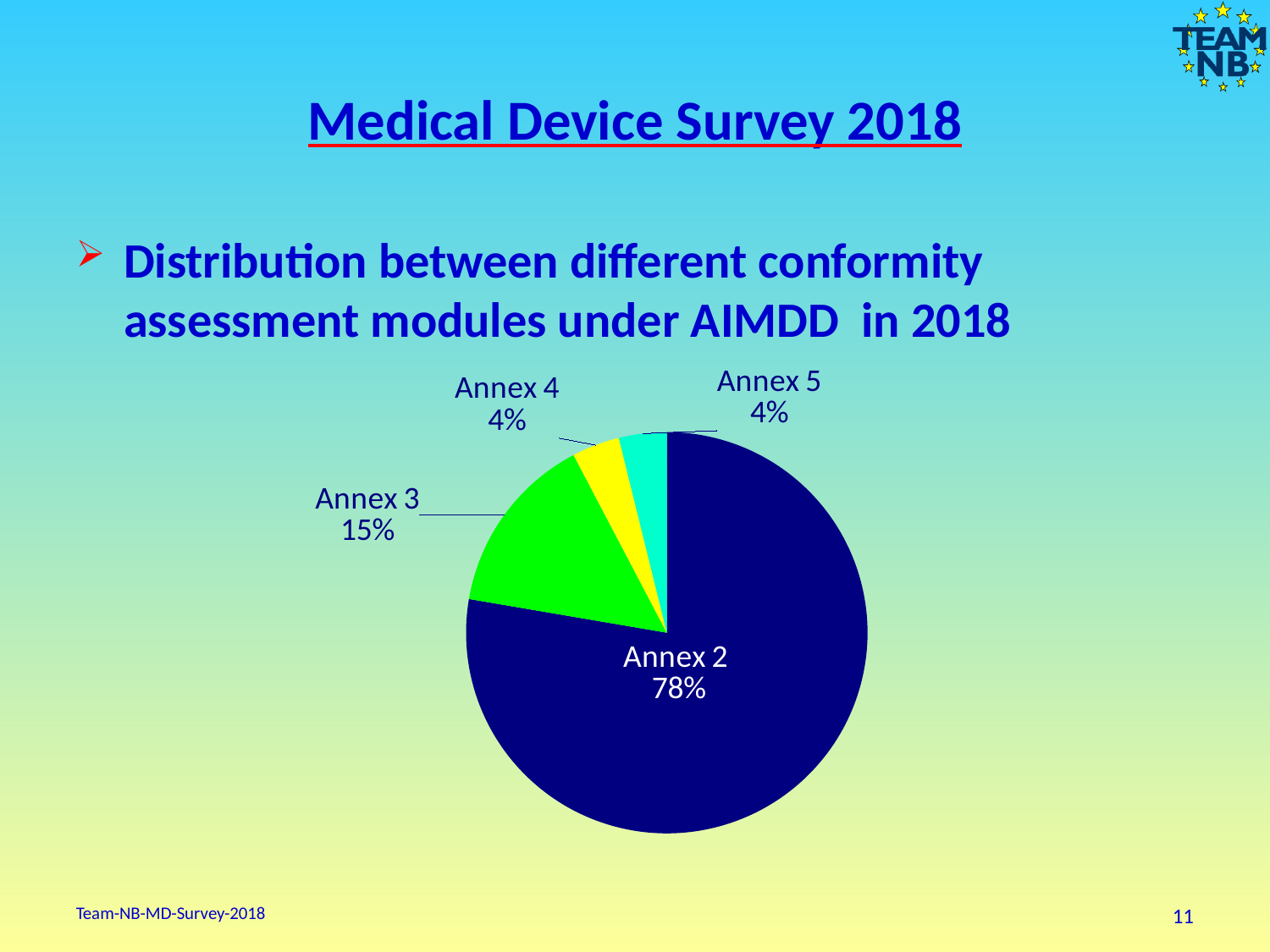
How many slices does the pie chart have? 4 What share of the pie does Annex 2 represent? 78% What kind of chart is shown on the slide? pie chart What is the value shown for Annex 5? 4% What colour is the Annex 3 slice of the pie? green What is the combined share of Annex 4 and Annex 5? 8% Which is larger, the share for Annex 3 or the share for Annex 4? Annex 3 What is the value shown for Annex 4? 4% What share of the pie does Annex 3 represent? 15% What is the difference in percentage points between Annex 2 and Annex 3? 63 Which annex has the largest share of the pie? Annex 2 What colour is the Annex 2 slice of the pie? dark blue